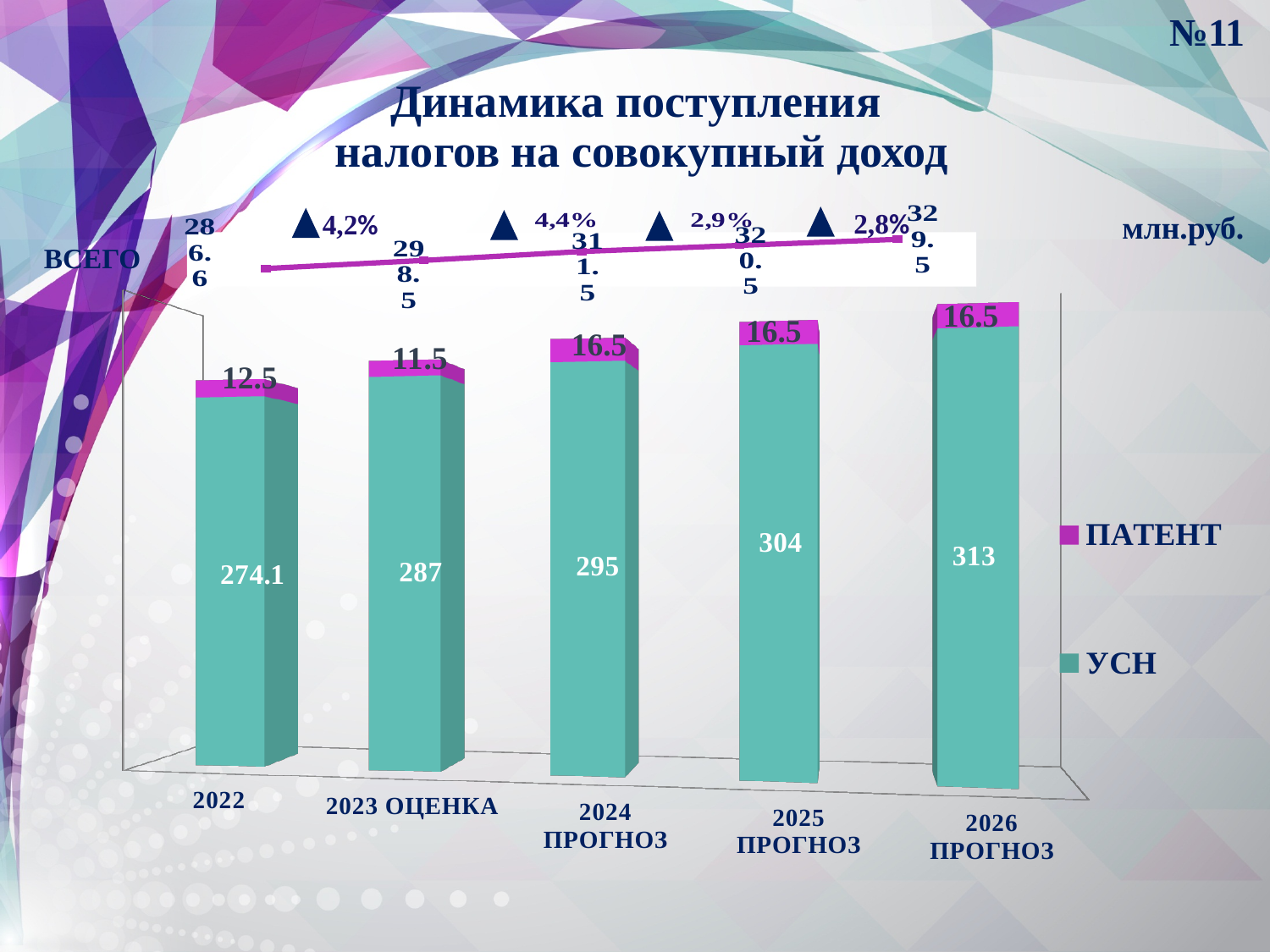
Which category has the lowest ПАТЕНТ value? 2023 ОЦЕНКА Which is larger, the ПАТЕНТ value for 2022 or for 2023 ОЦЕНКА? 2022 Do the УСН values rise or fall from 2022 to 2026 ПРОГНОЗ? rise How many categories are shown on the x axis? 5 Which category has the highest УСН value? 2026 ПРОГНОЗ What is the УСН value for 2026 ПРОГНОЗ? 313 What is the total (ВСЕГО) of the stacked bar for 2024 ПРОГНОЗ? 311.5 What is the difference between the УСН values for 2025 ПРОГНОЗ and 2024 ПРОГНОЗ? 9 What is the УСН value for 2022? 274.1 What kind of chart is shown on the slide? stacked bar chart How many series does the legend list? 2 What is the ПАТЕНТ value for 2023 ОЦЕНКА? 11.5